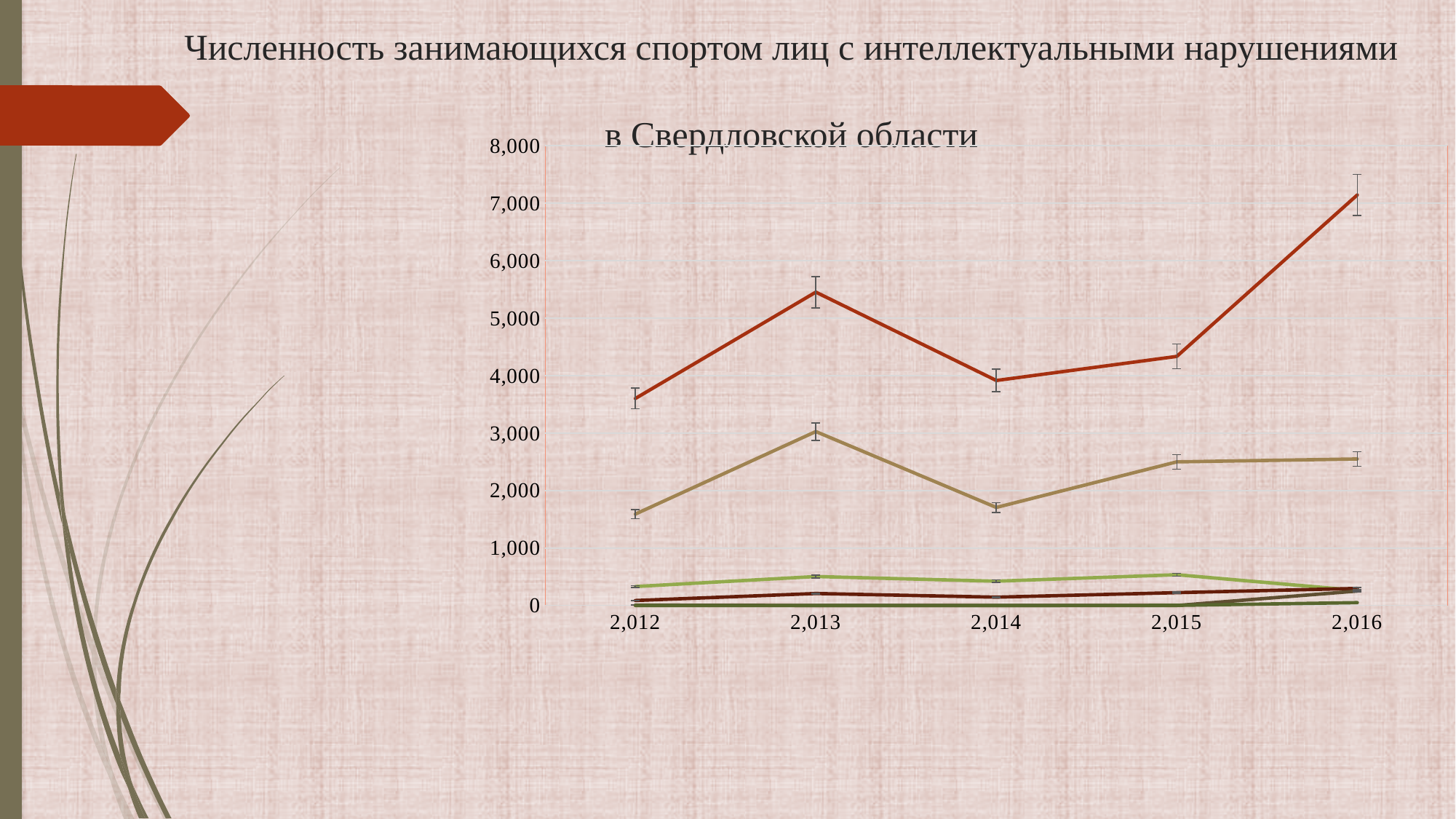
Is the value of the topmost (red) line in 2,012 greater or less than 4,000? less Is the value of the topmost (red) line in 2,016 greater or less than 6,000? greater What is the highest value shown on the y axis of the chart? 8,000 For the topmost (red) line, which year has the larger value, 2,013 or 2,015? 2,013 What kind of chart is shown on the slide? line chart In which year does the topmost (red) line have its lowest value? 2,012 Is the value of the second-highest (tan) line in 2,012 greater or less than 2,000? less In which year does the second-highest (tan) line reach its highest value? 2,013 Does the topmost (red) line rise or fall between 2,015 and 2,016? rise How many years are shown along the x axis of the chart? 5 What is the title of the chart on the slide? Численность занимающихся спортом лиц с интеллектуальными нарушениями в Свердловской области In which year does the topmost (red) line reach its highest value? 2,016